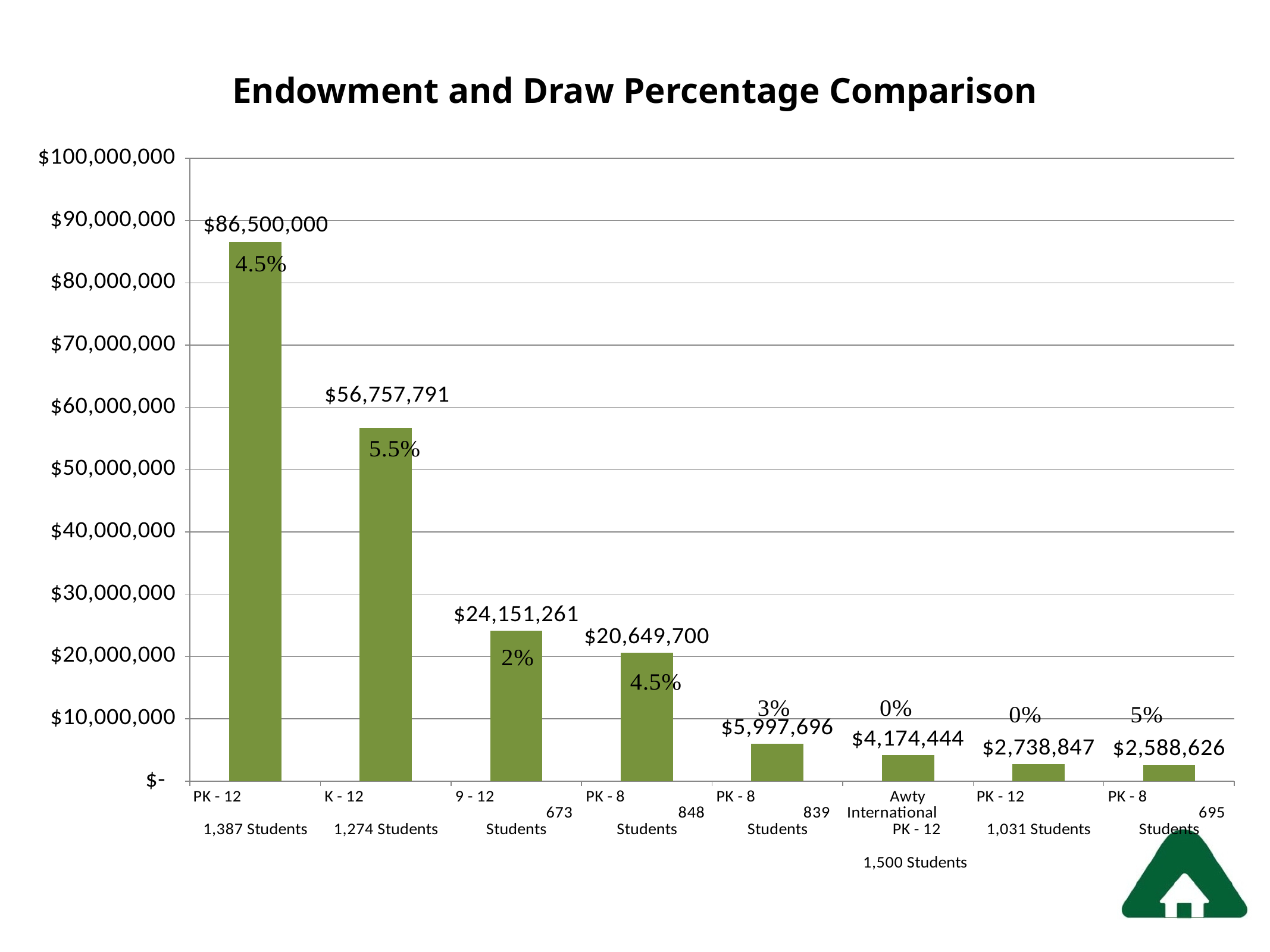
What draw percentage is shown on the bar for the 9 - 12 school with 673 students? 2% How many schools (bars) are shown in the chart? 8 What is the endowment value for Awty International (PK - 12, 1,500 students)? $4,174,444 Which is larger: the endowment of the 9 - 12 school with 673 students or the PK - 8 school with 848 students? 9 - 12, 673 Students What type of chart is shown on the slide? bar chart Which school has the lowest endowment? PK - 8, 695 Students What is the title of the chart? Endowment and Draw Percentage Comparison What is the endowment value for the K - 12 school with 1,274 students? $56,757,791 Which school has the highest endowment? PK - 12, 1,387 Students Is the endowment for the PK - 8 school with 839 students greater or less than $10,000,000? less What is the difference between the endowment of the PK - 12 school with 1,387 students and the K - 12 school with 1,274 students? $29,742,209 What is the endowment value for the PK - 8 school with 695 students? $2,588,626